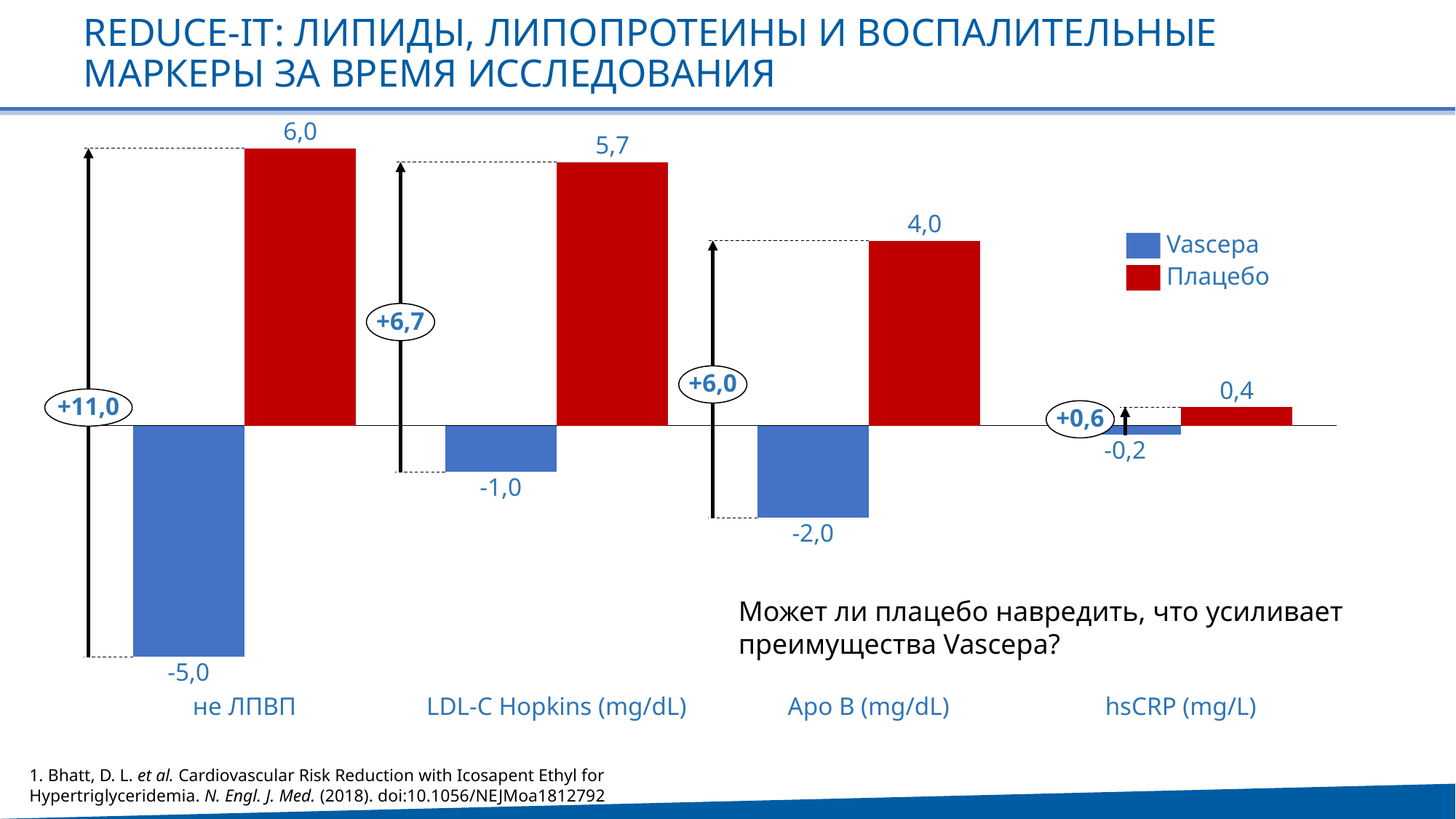
Which is larger: the Плацебо value for LDL-C Hopkins (mg/dL) or the Плацебо value for Apo B (mg/dL)? LDL-C Hopkins (mg/dL) What kind of chart is shown on the slide? Bar chart What is the difference between the Плацебо and Vascepa values for Apo B (mg/dL)? 6,0 What is the Плацебо value for не ЛПВП? 6,0 What is the Vascepa value for hsCRP (mg/L)? -0,2 How many series does the legend list? 2 Which category has the highest Плацебо value? не ЛПВП What is the Vascepa value for LDL-C Hopkins (mg/dL)? -1,0 How many categories are shown on the x axis of the chart? 4 What is the Плацебо value for Apo B (mg/dL)? 4,0 Which category has the lowest Vascepa value? не ЛПВП Which colour represents Плацебо in the legend? Red